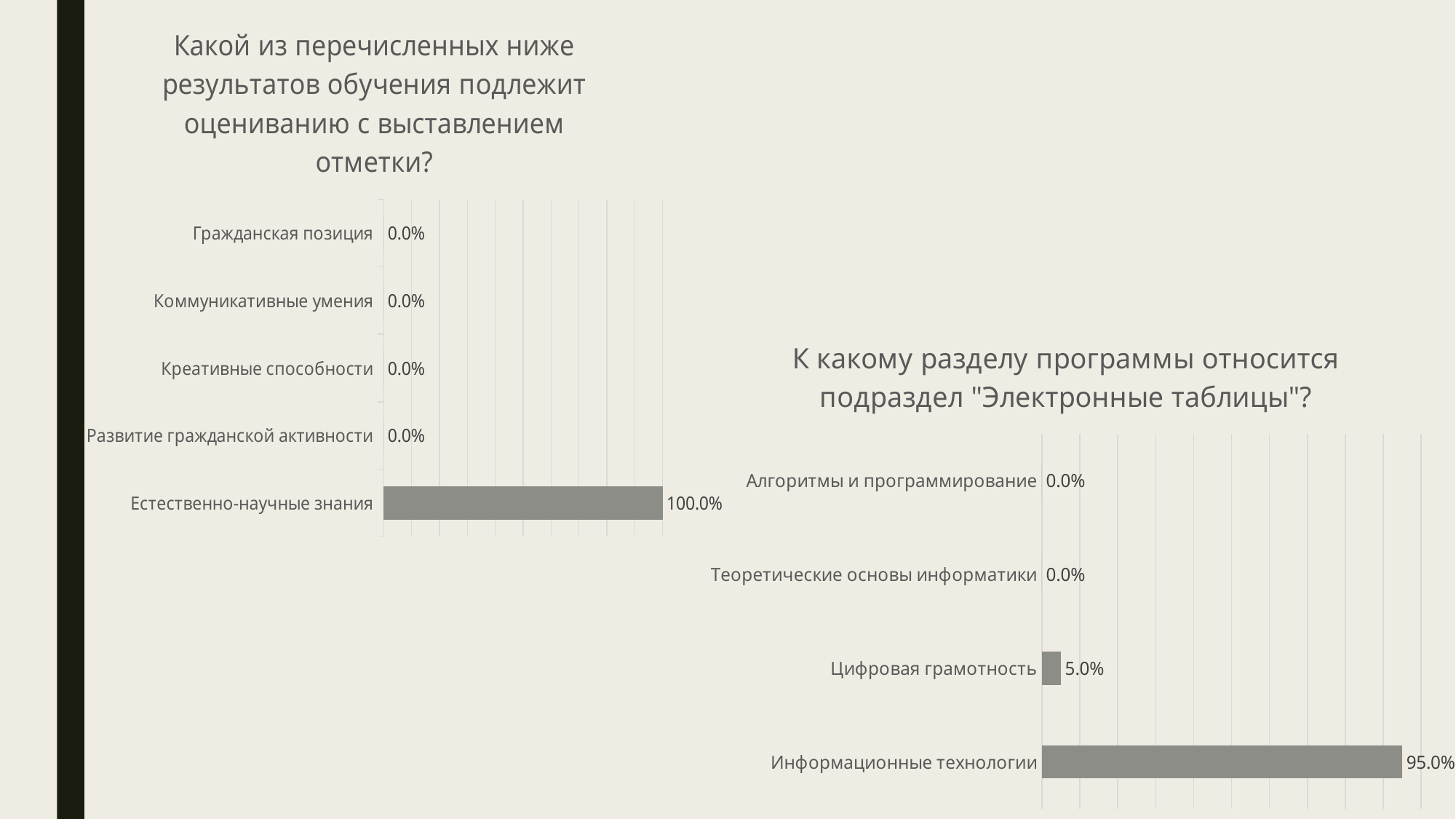
In the right chart, what is the value for Цифровая грамотность? 5.0% In the left chart, which category has the highest value? Естественно-научные знания What kind of chart is the left chart? Bar chart In the left chart, what is the value for Гражданская позиция? 0.0% How many categories are shown in the left chart? 5 In the right chart ("К какому разделу программы относится подраздел "Электронные таблицы"?"), what is the value for Информационные технологии? 95.0% In the right chart, what is the difference between the values for Информационные технологии and Цифровая грамотность? 90.0% In the left chart ("Какой из перечисленных ниже результатов обучения подлежит оцениванию с выставлением отметки?"), what is the value for Естественно-научные знания? 100.0% How many categories are shown in the right chart? 4 In the right chart, what is the value for Теоретические основы информатики? 0.0% In the right chart, which is larger: the value for Цифровая грамотность or the value for Алгоритмы и программирование? Цифровая грамотность In the right chart, which category has the highest value? Информационные технологии